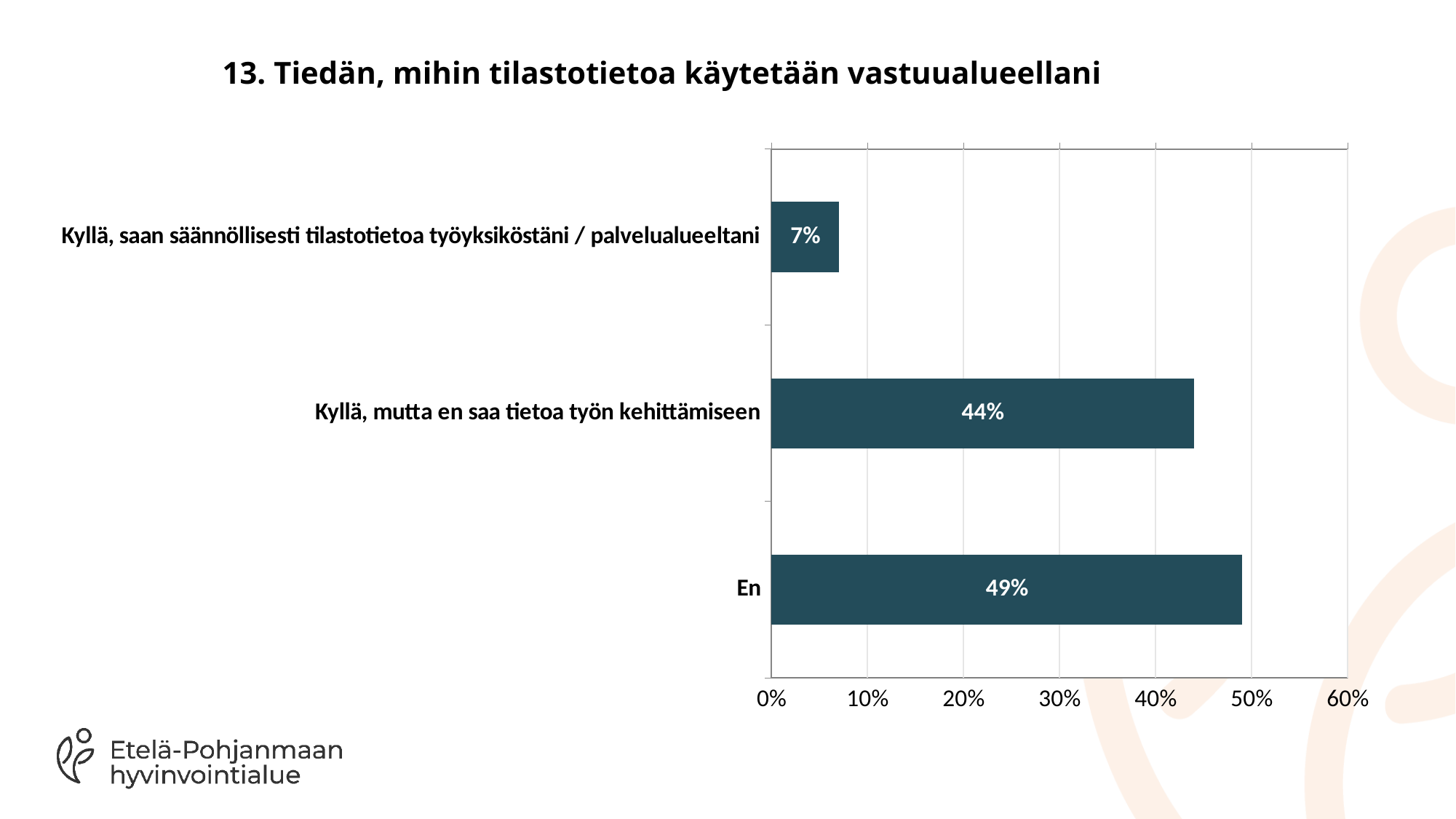
Which is larger: the value for "En" or the value for "Kyllä, mutta en saa tietoa työn kehittämiseen"? En What is the difference between the values for "En" and "Kyllä, mutta en saa tietoa työn kehittämiseen"? 5% What is the title of the chart? 13. Tiedän, mihin tilastotietoa käytetään vastuualueellani Which category has the lowest value? Kyllä, saan säännöllisesti tilastotietoa työyksiköstäni / palvelualueeltani What is the value for "Kyllä, mutta en saa tietoa työn kehittämiseen"? 44% What is the difference between the values for "Kyllä, mutta en saa tietoa työn kehittämiseen" and "Kyllä, saan säännöllisesti tilastotietoa työyksiköstäni / palvelualueeltani"? 37% What is the value for "En"? 49% Is the value for "En" greater or less than 40%? greater Which category has the highest value? En How many categories are shown in the chart? 3 What is the value for "Kyllä, saan säännöllisesti tilastotietoa työyksiköstäni / palvelualueeltani"? 7% What kind of chart is shown on the slide? Bar chart